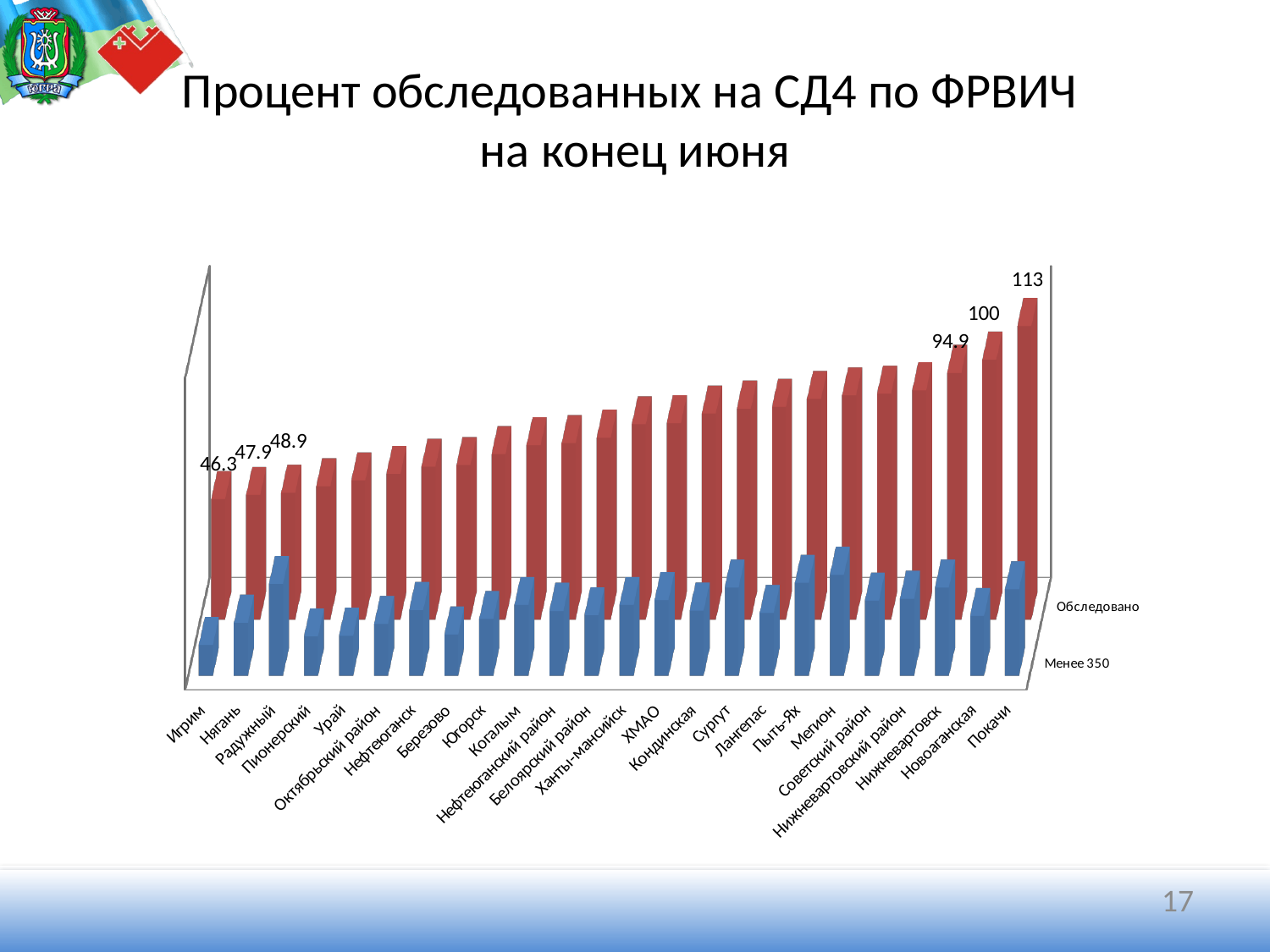
What is the Обследовано value for Нягань? 47.9 What is the Обследовано value for Покачи? 113 What is the Обследовано value for Игрим? 46.3 Which category has the highest Обследовано value? Покачи Which has a larger Обследовано value, Покачи or Новоаганская? Покачи Which category has the lowest Обследовано value? Игрим What is the Обследовано value for Нижневартовск? 94.9 Do the Обследовано values rise or fall from left to right along the x axis? rise How many series does the chart show? 2 What is the difference between the Обследовано values for Покачи and Игрим? 66.7 What is the Обследовано value for Новоаганская? 100 How many categories are shown on the x axis? 24